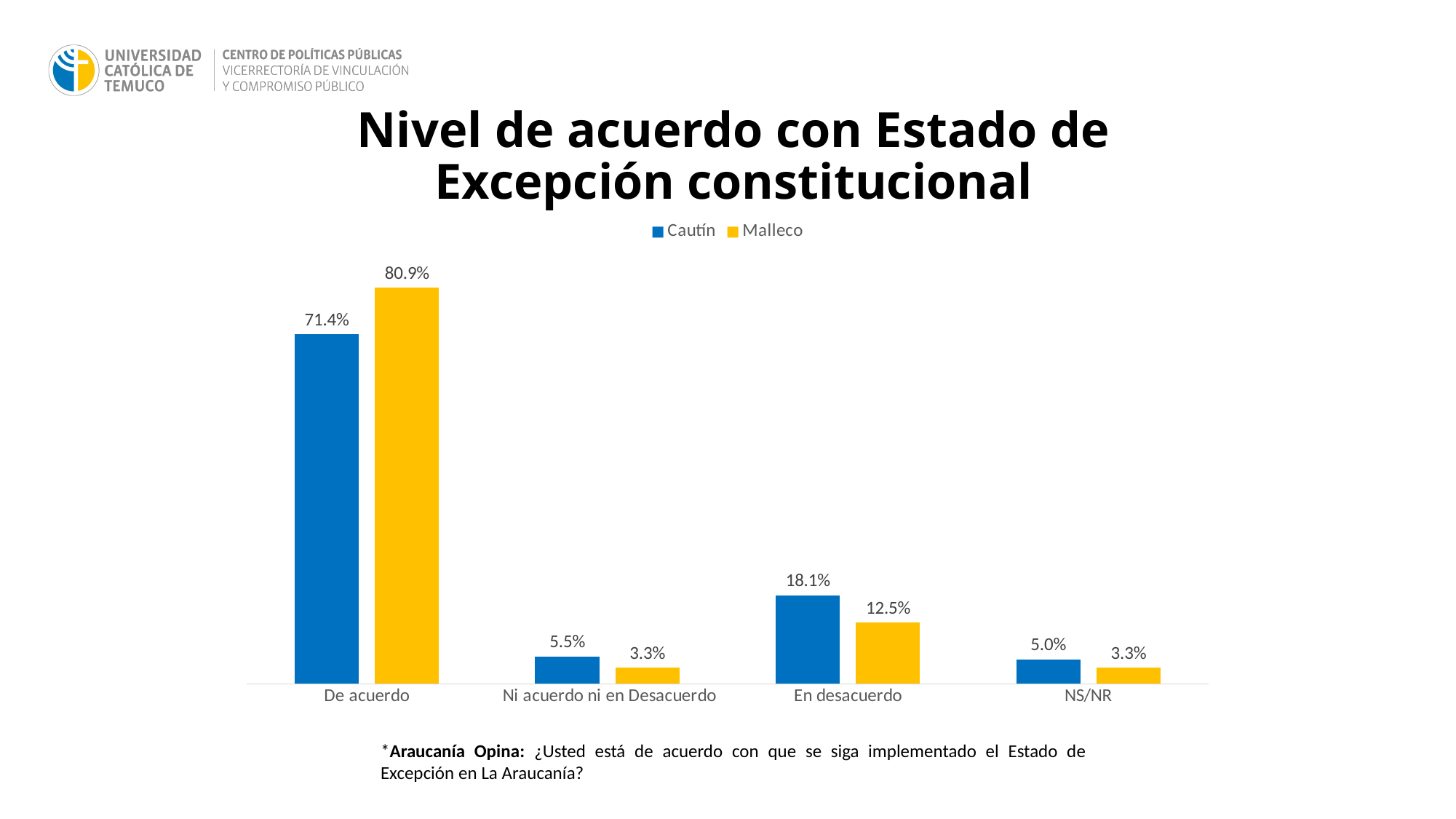
What kind of chart is shown on the slide? Bar chart What is the value for Cautín in the 'Ni acuerdo ni en Desacuerdo' category? 5.5% How many categories are shown on the x axis? 4 Which category has the lowest value for Cautín? NS/NR What is the value for Malleco in the 'NS/NR' category? 3.3% Which category has the highest value for Cautín? De acuerdo What is the difference between the Cautín and Malleco values in the 'En desacuerdo' category? 5.6% What is the value for Cautín in the 'En desacuerdo' category? 18.1% What is the difference between the Malleco and Cautín values in the 'De acuerdo' category? 9.5% What is the value for Malleco in the 'De acuerdo' category? 80.9% How many series does the legend list? 2 In the 'Ni acuerdo ni en Desacuerdo' category, which series has the larger value, Cautín or Malleco? Cautín